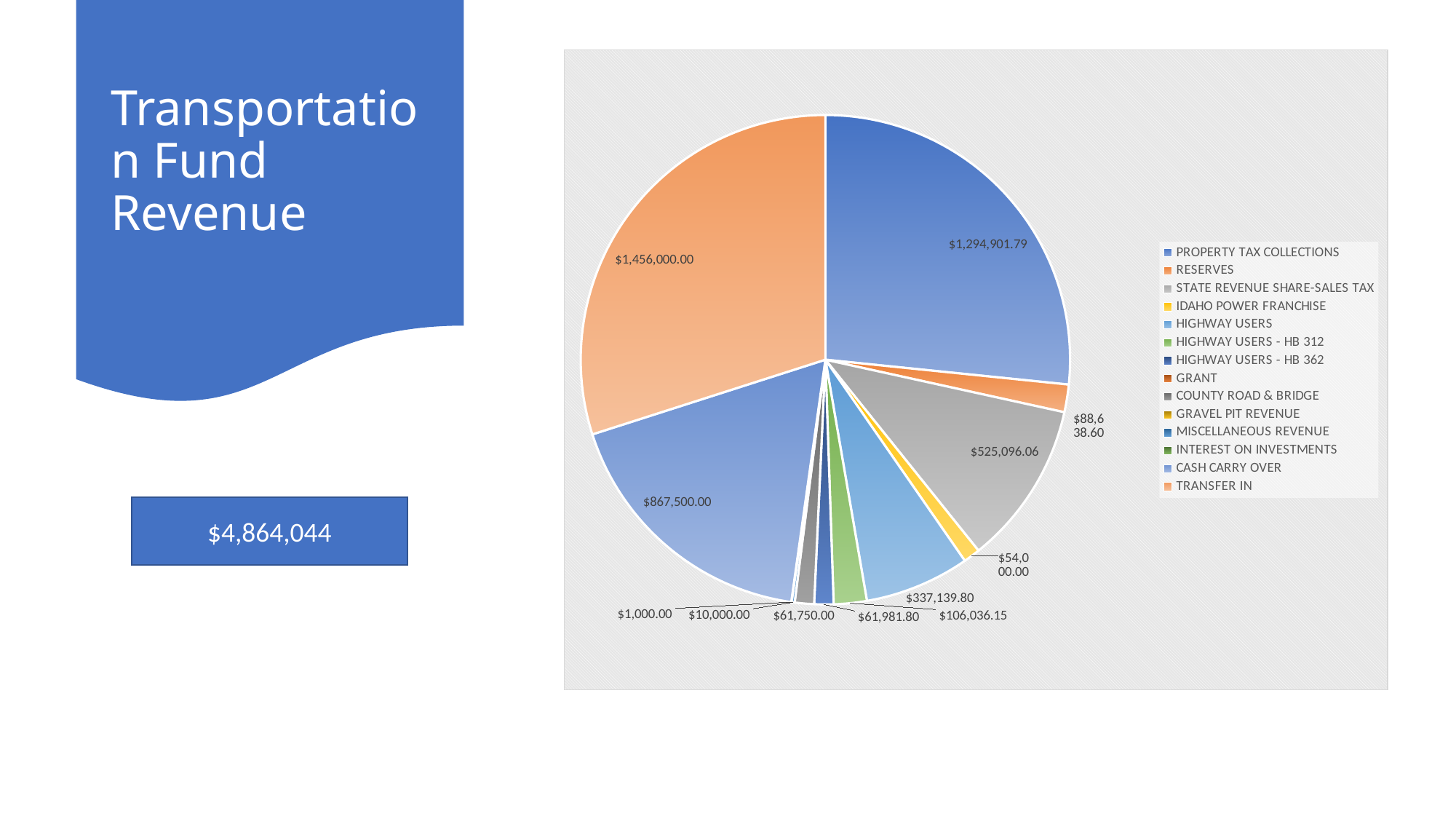
What is the value of the HIGHWAY USERS slice? $337,139.80 Which is larger, PROPERTY TAX COLLECTIONS or CASH CARRY OVER? PROPERTY TAX COLLECTIONS How many categories are listed in the legend? 14 What is the value of the CASH CARRY OVER slice? $867,500.00 What is the value of the PROPERTY TAX COLLECTIONS slice? $1,294,901.79 What is the title of the slide containing the pie chart? Transportation Fund Revenue What type of chart is shown on the slide? Pie chart What is the difference between the TRANSFER IN value and the PROPERTY TAX COLLECTIONS value? $161,098.21 What is the value of the TRANSFER IN slice? $1,456,000.00 What is the value of the STATE REVENUE SHARE-SALES TAX slice? $525,096.06 Which category has the largest slice of the pie? TRANSFER IN What is the value of the IDAHO POWER FRANCHISE slice? $54,000.00